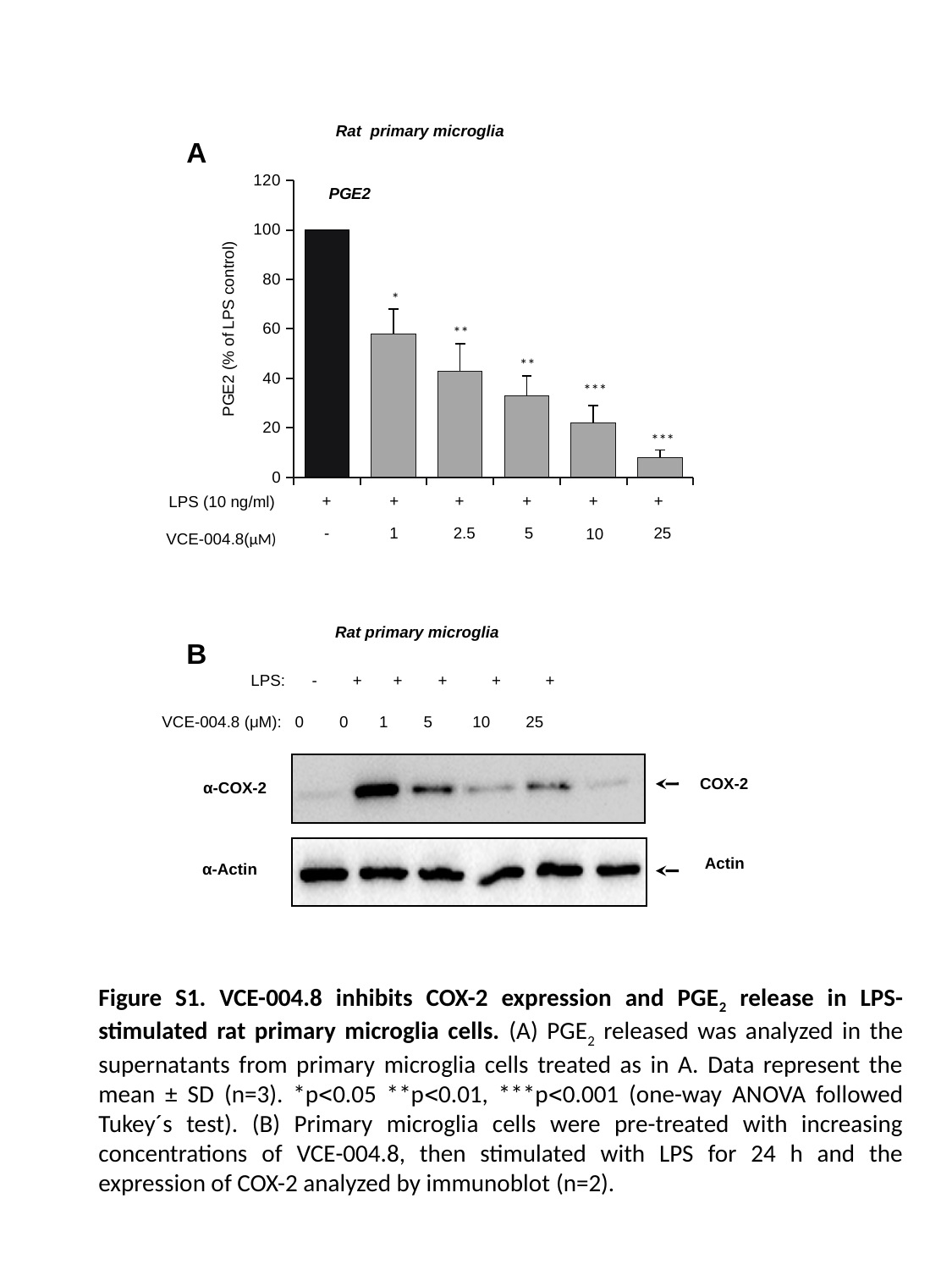
In the bar chart in panel A, which condition has the highest PGE2 value? LPS alone (no VCE-004.8) In the bar chart in panel A, is the PGE2 value at 1 µM VCE-004.8 greater or less than 40? greater In the bar chart in panel A, is the PGE2 value at 10 µM VCE-004.8 greater or less than 40? less In the bar chart in panel A, which VCE-004.8 concentration gives the lowest PGE2 value? 25 µM In the bar chart in panel A, is the PGE2 value at 5 µM VCE-004.8 greater or less than 40? less In the bar chart in panel A, how does the PGE2 value change as the VCE-004.8 concentration increases from left to right? It falls What is the label on the y-axis of the bar chart in panel A? PGE2 (% of LPS control) What kind of chart is shown in panel A of the slide? bar chart In the bar chart in panel A, which has the larger PGE2 value: 2.5 µM or 10 µM VCE-004.8? 2.5 µM In the bar chart in panel A, what is the PGE2 value (% of LPS control) for the LPS-only condition with no VCE-004.8? 100 In the bar chart in panel A, how many bars are plotted? 6